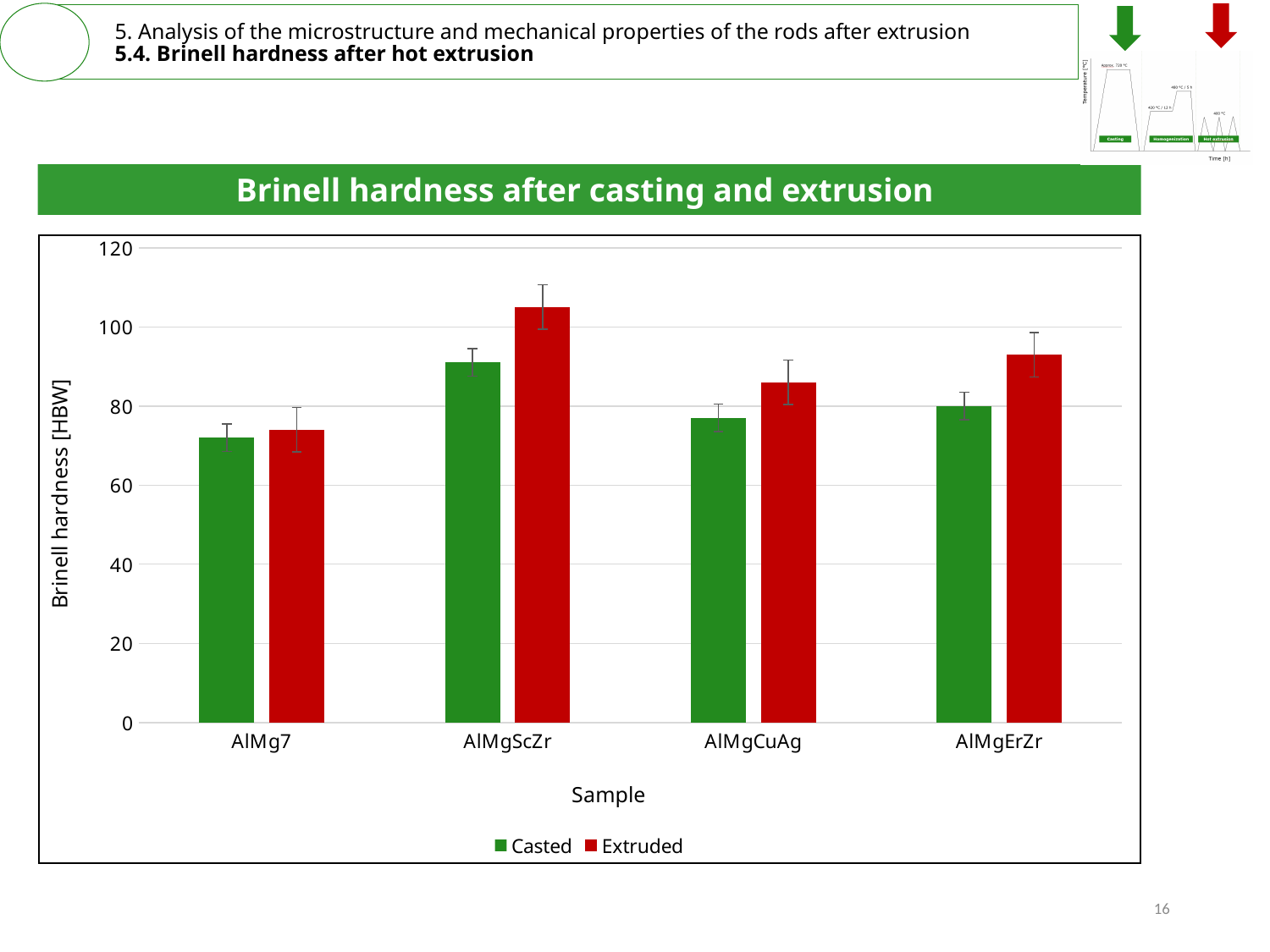
How many series does the chart legend list? 2 What is the title of the chart? Brinell hardness after casting and extrusion Which is larger for AlMgErZr, the Casted or the Extruded Brinell hardness? Extruded Is the Extruded Brinell hardness for AlMgScZr greater or less than 100? greater What kind of chart is shown on the slide? bar chart Which sample has the highest Extruded Brinell hardness? AlMgScZr Is the Casted Brinell hardness for AlMg7 greater or less than 80? less Which sample has the highest Casted Brinell hardness? AlMgScZr Which is larger for AlMgScZr, the Casted or the Extruded Brinell hardness? Extruded How many samples are shown on the x axis of the chart? 4 Which sample has the lowest Casted Brinell hardness? AlMg7 What colour represents the Extruded series in the chart? red